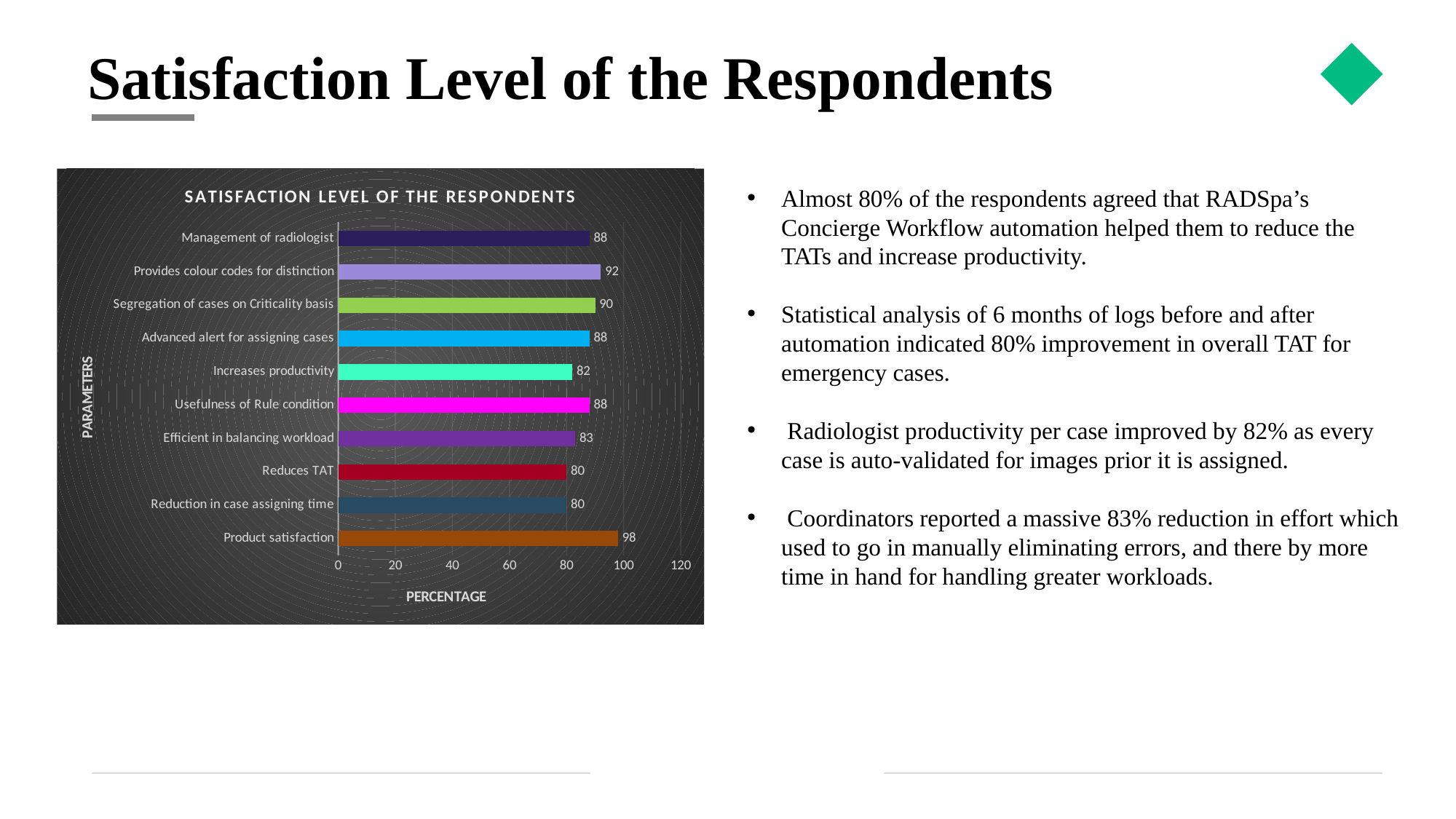
What is the title of the chart? SATISFACTION LEVEL OF THE RESPONDENTS What kind of chart is shown? bar chart Is the value for Increases productivity greater or less than 100? less What is the label of the horizontal axis? PERCENTAGE Which is larger, Segregation of cases on Criticality basis or Increases productivity? Segregation of cases on Criticality basis What is the value for Reduction in case assigning time? 80 How many parameters are shown in the chart? 10 What is the value for Product satisfaction? 98 What is the value for Provides colour codes for distinction? 92 What is the value for Efficient in balancing workload? 83 Which parameter has the highest value? Product satisfaction What is the difference between Product satisfaction and Reduces TAT? 18